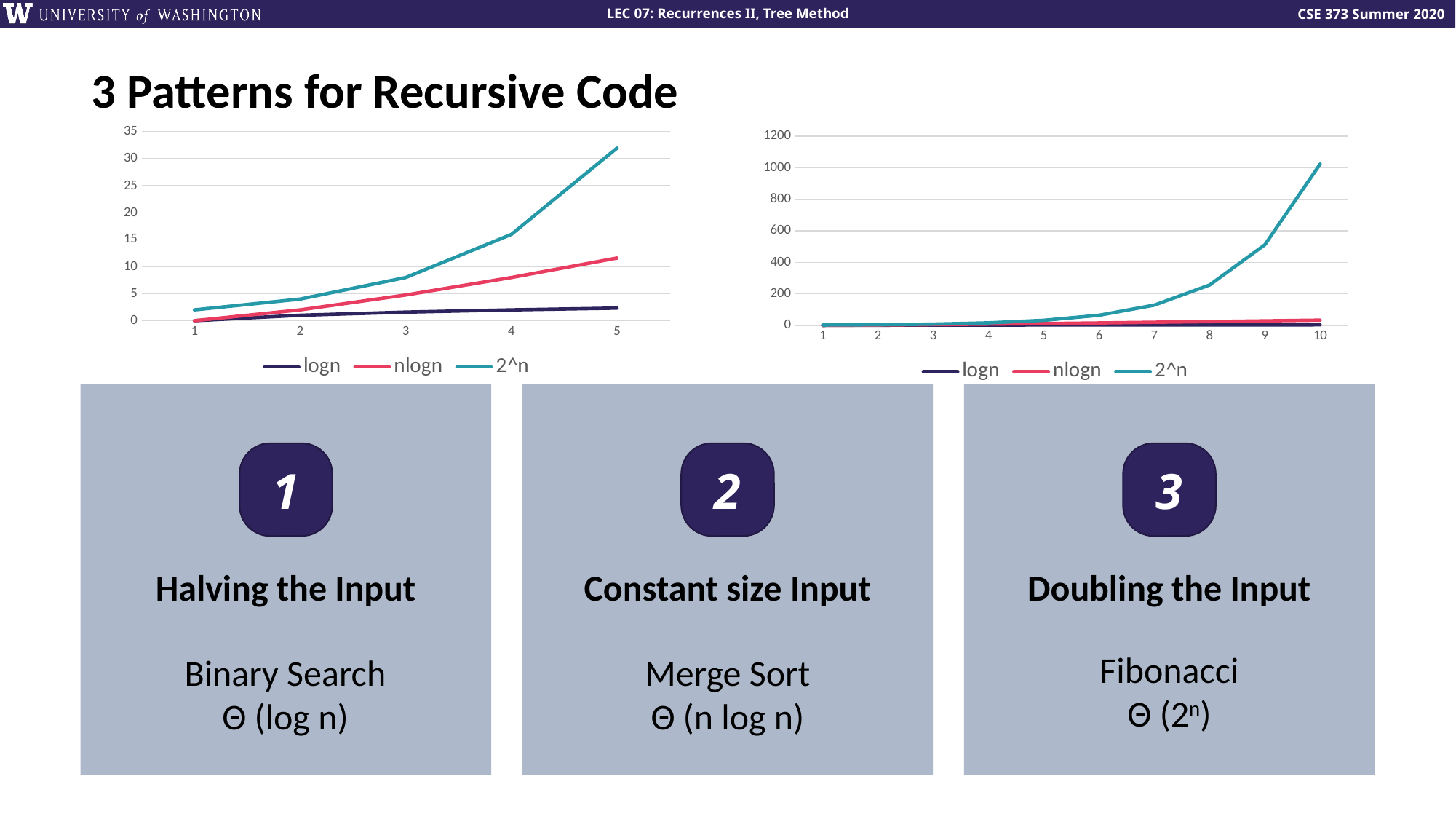
In the right chart, is the value of 2^n at x = 10 greater or less than 800? greater In the left chart, which series has the lowest value at x = 5? logn In the left chart, is the value of nlogn at x = 5 greater or less than 15? less How many points are plotted along the x axis of the left chart? 5 In the left chart, which series has the highest value at x = 5? 2^n In the left chart, is the value of 2^n at x = 5 greater or less than 30? greater In the right chart, does the 2^n series rise or fall as x increases? rise How many points are plotted along the x axis of the right chart? 10 What kind of chart is the chart on the left of the slide? line chart In the left chart, at x = 5, which is larger: nlogn or logn? nlogn How many series does the legend of the left chart list? 3